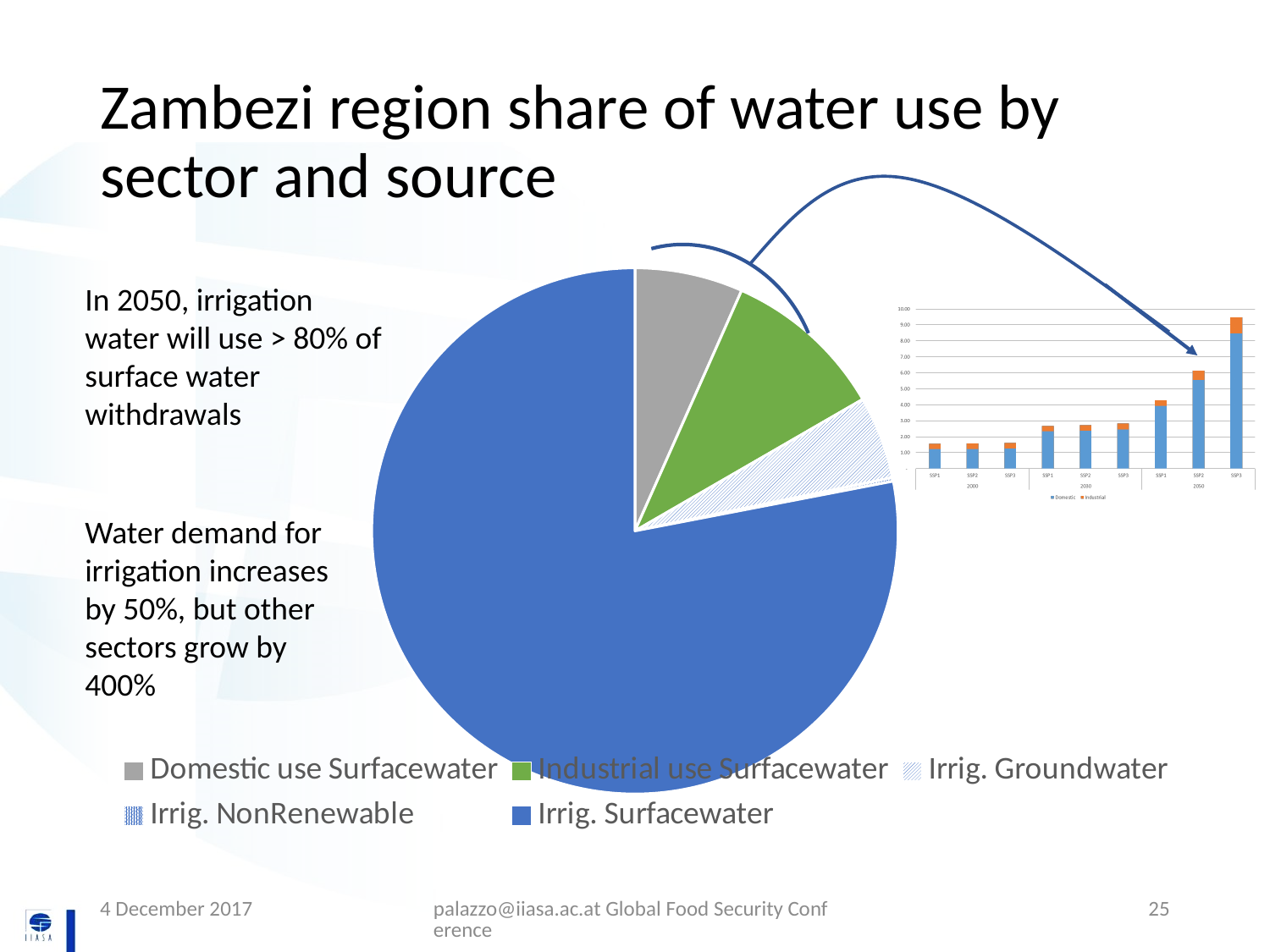
In the pie chart, which is larger: the slice for Irrig. Surfacewater or the slice for Domestic use Surfacewater? Irrig. Surfacewater What kind of chart is the small inset chart on the right of the slide? bar chart How many bars are plotted in the small inset bar chart? 9 In the pie chart, which is larger: the slice for Industrial use Surfacewater or the slice for Irrig. Groundwater? Industrial use Surfacewater What kind of chart is the large chart in the centre of the slide? pie chart In the small inset bar chart, which bar is the tallest? SSP3 2050 In the pie chart, which category has the largest slice? Irrig. Surfacewater In the small inset bar chart, is the total for SSP3 in 2050 greater or less than 8.00? greater In the pie chart, what colour is the slice for Irrig. Surfacewater? blue How many entries does the legend of the pie chart list? 5 In the small inset bar chart, do the bar totals rise or fall from 2000 to 2050? rise How many series does the legend of the small inset bar chart list? 2